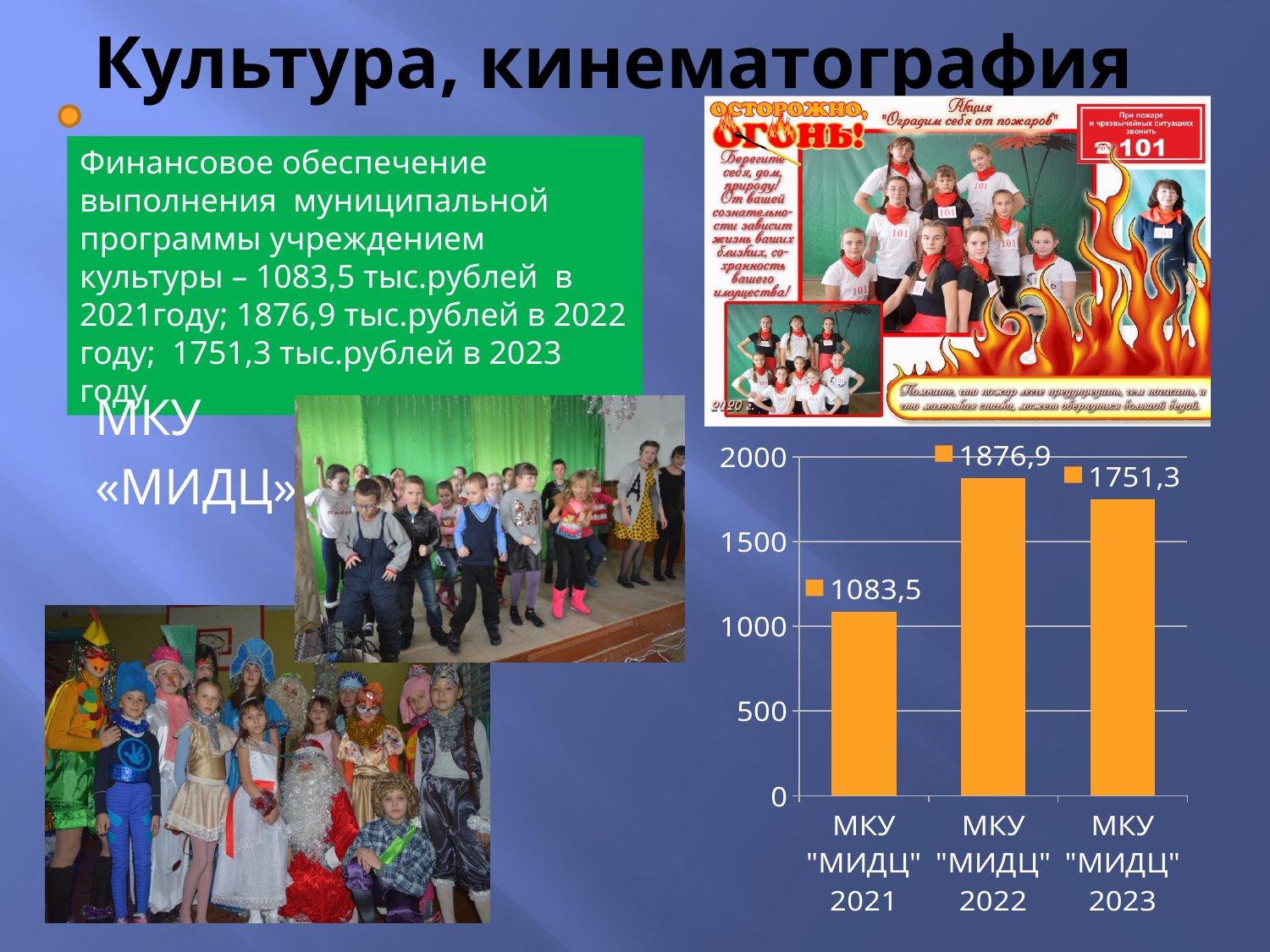
What kind of chart is shown on the slide? bar chart Which category has the highest value in the bar chart? МКУ "МИДЦ" 2022 What is the value for МКУ "МИДЦ" 2022 in the bar chart? 1876,9 What colour are the bars in the chart? orange What is the value for МКУ "МИДЦ" 2023 in the bar chart? 1751,3 What is the difference between the values for МКУ "МИДЦ" 2022 and МКУ "МИДЦ" 2021? 793,4 How many bars are shown in the chart? 3 Which is larger: the value for МКУ "МИДЦ" 2023 or МКУ "МИДЦ" 2021? МКУ "МИДЦ" 2023 Is the value for МКУ "МИДЦ" 2021 greater or less than 1500? less Which category has the lowest value in the bar chart? МКУ "МИДЦ" 2021 What is the value for МКУ "МИДЦ" 2021 in the bar chart? 1083,5 What is the difference between the values for МКУ "МИДЦ" 2022 and МКУ "МИДЦ" 2023? 125,6